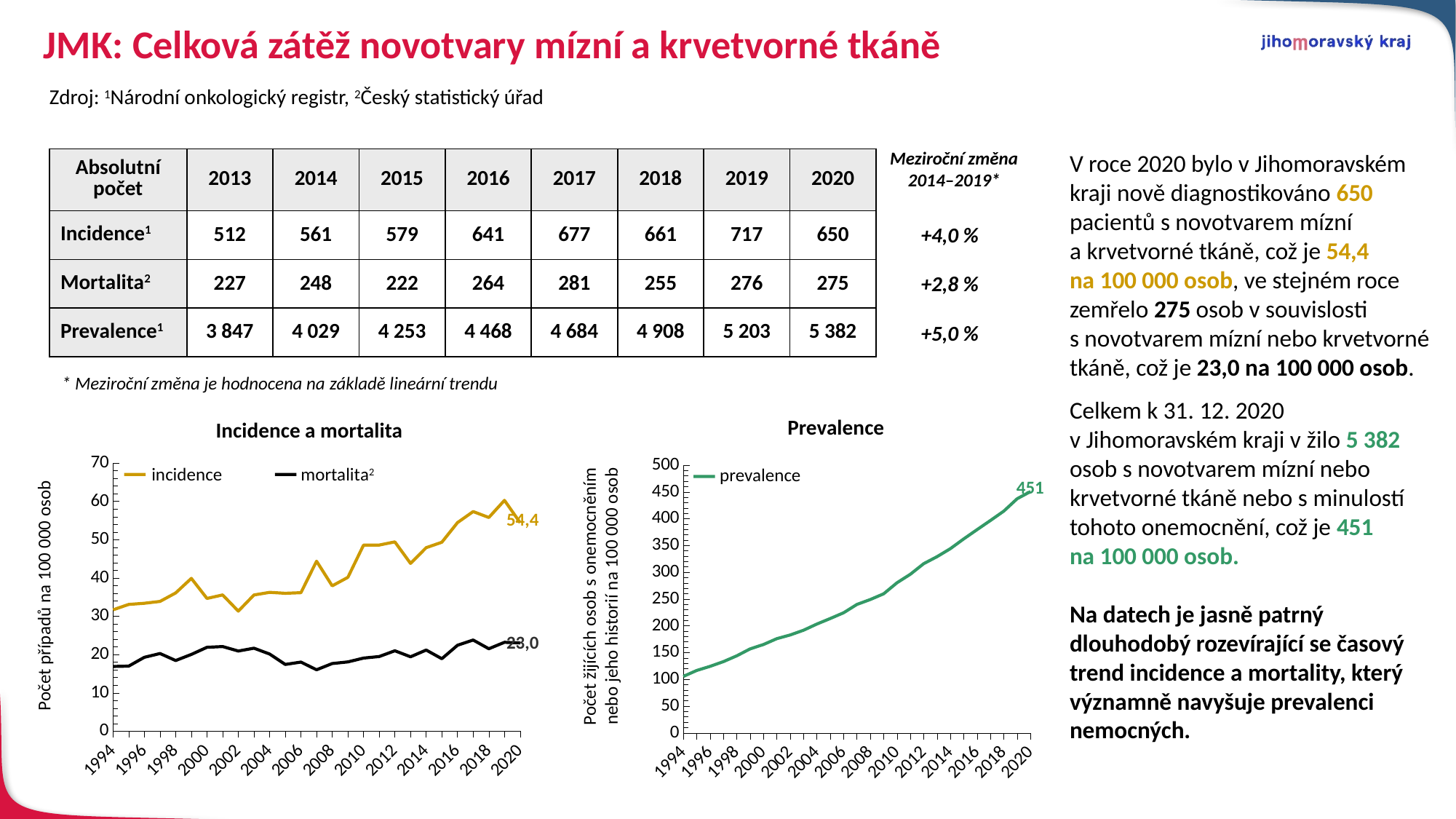
In the 'Prevalence' chart, do the values rise or fall from 1994 to 2020? rise In the 'Incidence a mortalita' chart, is the mortalita value for 2020 greater or less than 30? less In the 'Incidence a mortalita' chart, what is the labelled value of mortalita in 2020? 23,0 In the 'Incidence a mortalita' chart, what kind of chart is it? line chart In the 'Incidence a mortalita' chart, how many series does the legend list? 2 In the 'Prevalence' chart, how many series does the legend list? 1 In the 'Incidence a mortalita' chart, what is the labelled value of incidence in 2020? 54,4 In the 'Incidence a mortalita' chart, is the incidence value for 1994 greater or less than 40? less In the 'Prevalence' chart, what is the labelled value for 2020? 451 In the 'Prevalence' chart, is the value for 1994 greater or less than 150? less In the 'Incidence a mortalita' chart, what is the difference between the labelled incidence and mortalita values in 2020? 31,4 In the 'Incidence a mortalita' chart, which series has the higher value in 2020, incidence or mortalita? incidence